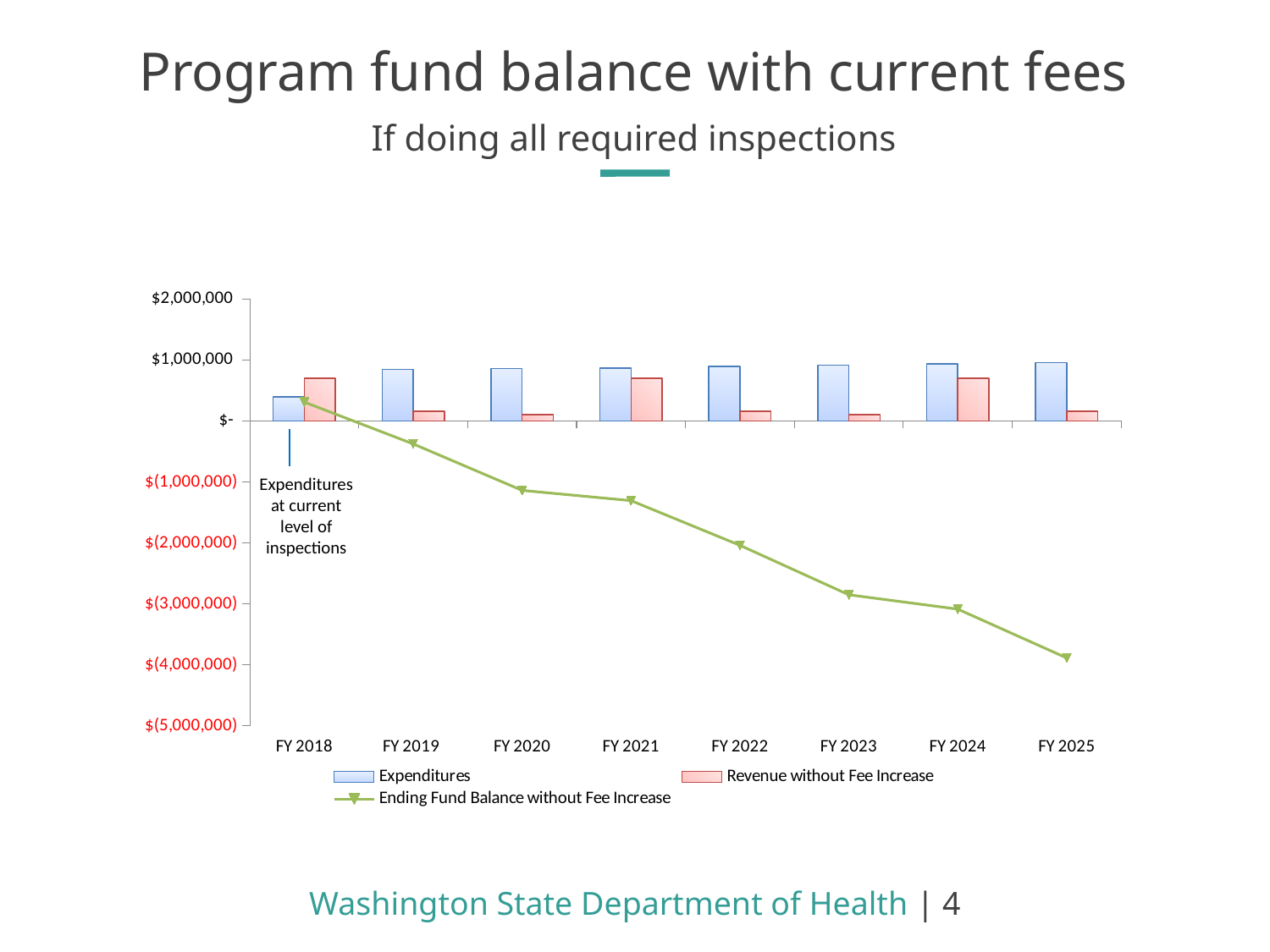
In which fiscal year is the Ending Fund Balance without Fee Increase lowest? FY 2025 What does the text annotation next to the FY 2018 bars say? Expenditures at current level of inspections How many fiscal years are shown on the x axis of the chart? 8 Is the Ending Fund Balance without Fee Increase for FY 2025 above or below $(3,000,000)? below How many series does the chart legend list? 3 In FY 2019, which is larger: Expenditures or Revenue without Fee Increase? Expenditures Does the Ending Fund Balance without Fee Increase line rise or fall from FY 2018 to FY 2025? Fall In which fiscal year are Expenditures lowest? FY 2018 In which fiscal year is the Ending Fund Balance without Fee Increase highest? FY 2018 In FY 2018, which is larger: Expenditures or Revenue without Fee Increase? Revenue without Fee Increase What kind of chart is shown on the slide? Combined bar and line chart Is the value of Expenditures for FY 2018 greater or less than $1,000,000? less